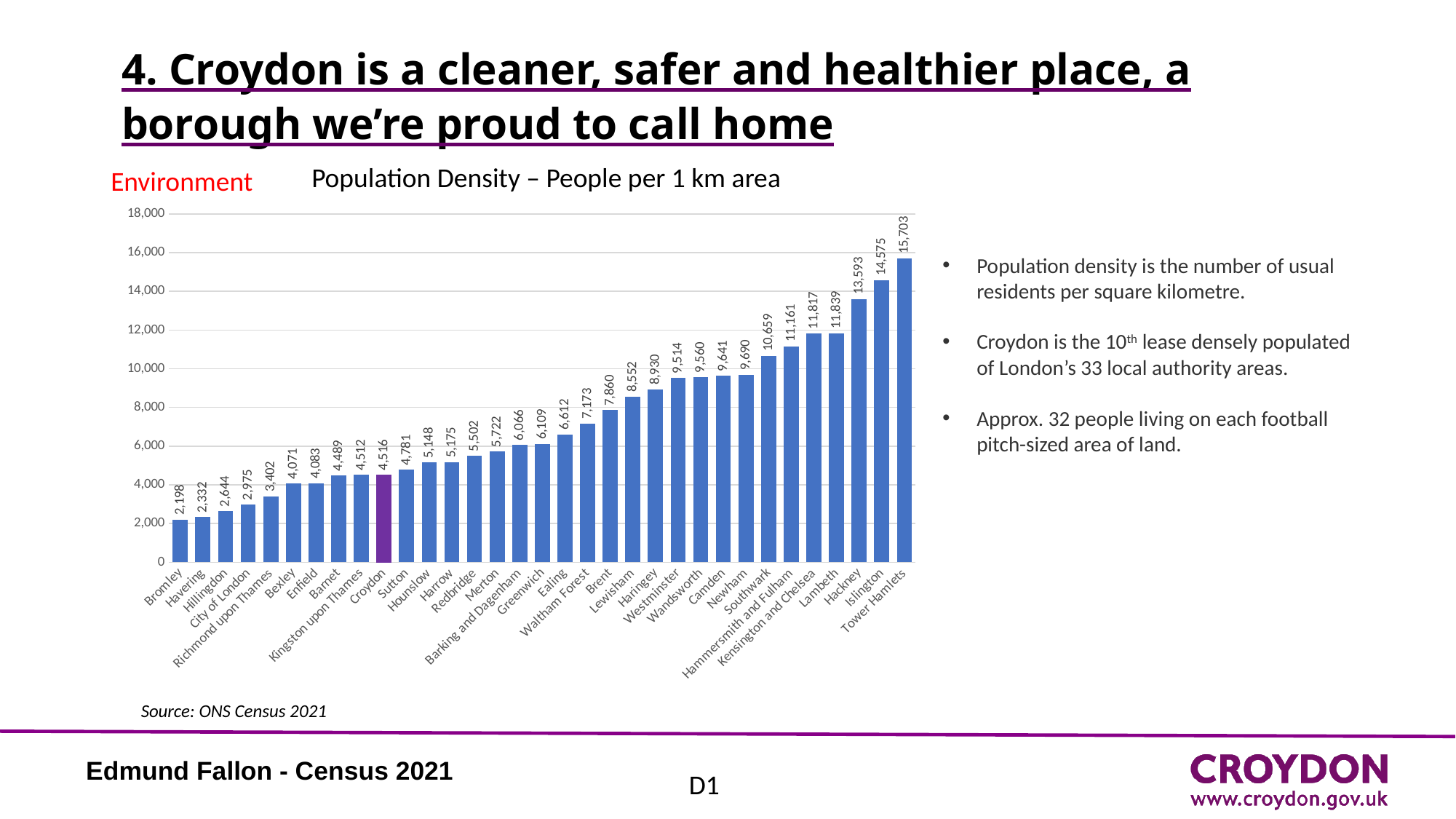
What is the population density value shown for Tower Hamlets? 15,703 Which bar in the chart is coloured differently (purple) from the others? Croydon How many boroughs are shown in the chart? 33 Is the value for Brent greater or less than 8,000? less What is the population density value shown for Croydon? 4,516 Which borough has the lowest population density in the chart? Bromley What is the difference between the population density of Islington and Hackney? 982 Which has a higher population density, Lambeth or Southwark? Lambeth What is the population density value shown for Bromley? 2,198 What type of chart is used to show population density? bar chart Do the values rise or fall from left to right along the x axis? rise Which borough has the highest population density in the chart? Tower Hamlets